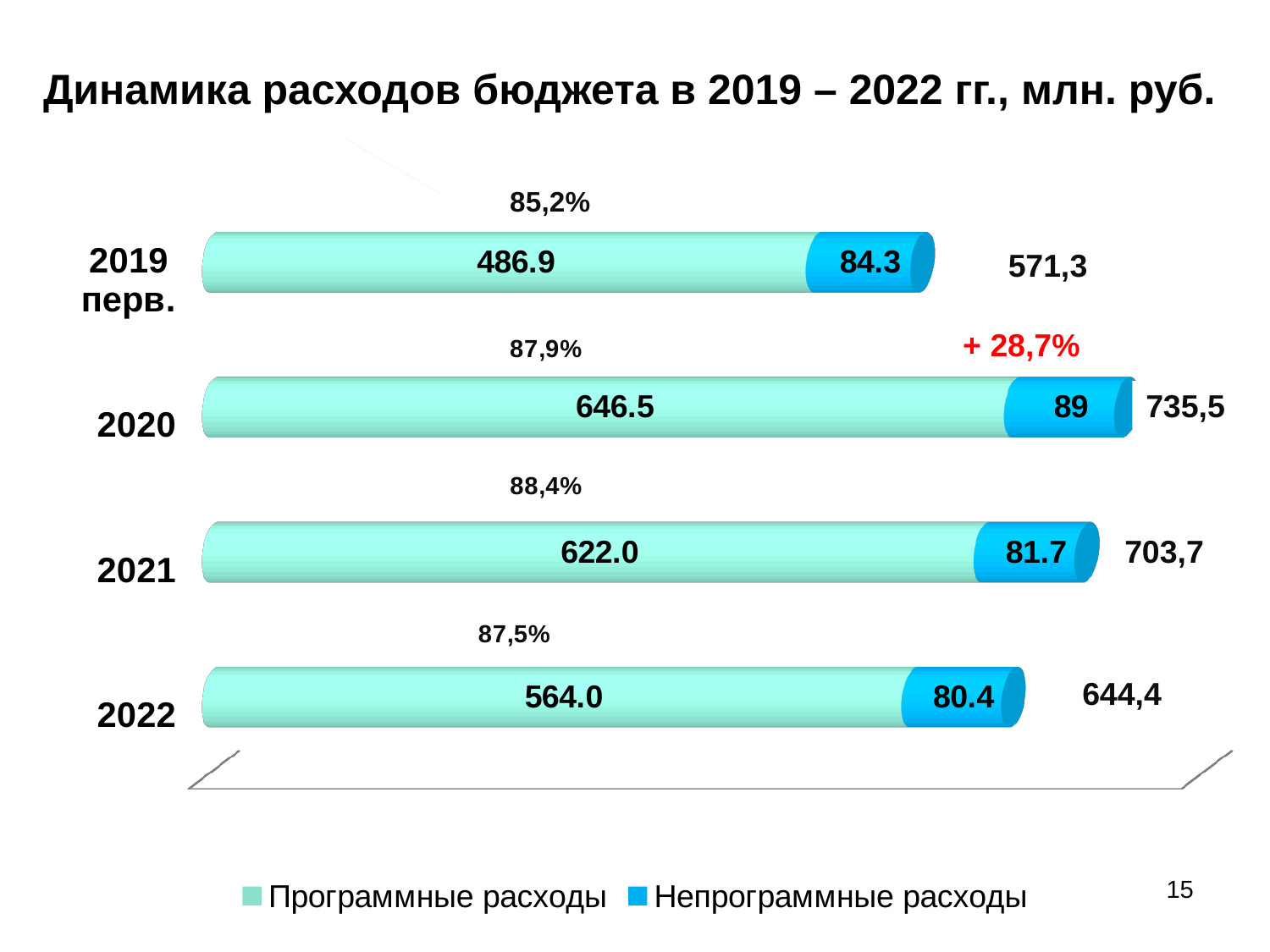
What is the total of the stacked bar for 2020? 735,5 What is the difference between Программные расходы in 2021 and in 2022? 58.0 What is the value of Программные расходы for 2020? 646.5 How many years (categories) are shown in the chart? 4 What kind of chart is shown on the slide? Stacked bar chart What is the value of Непрограммные расходы for 2022? 80.4 What is the value of Программные расходы for 2019 перв.? 486.9 Which year has the lowest value of Непрограммные расходы? 2022 How many series does the legend list? 2 What is the value of Непрограммные расходы for 2021? 81.7 Which year has the highest value of Программные расходы? 2020 Which is larger: Непрограммные расходы in 2019 перв. or in 2020? 2020